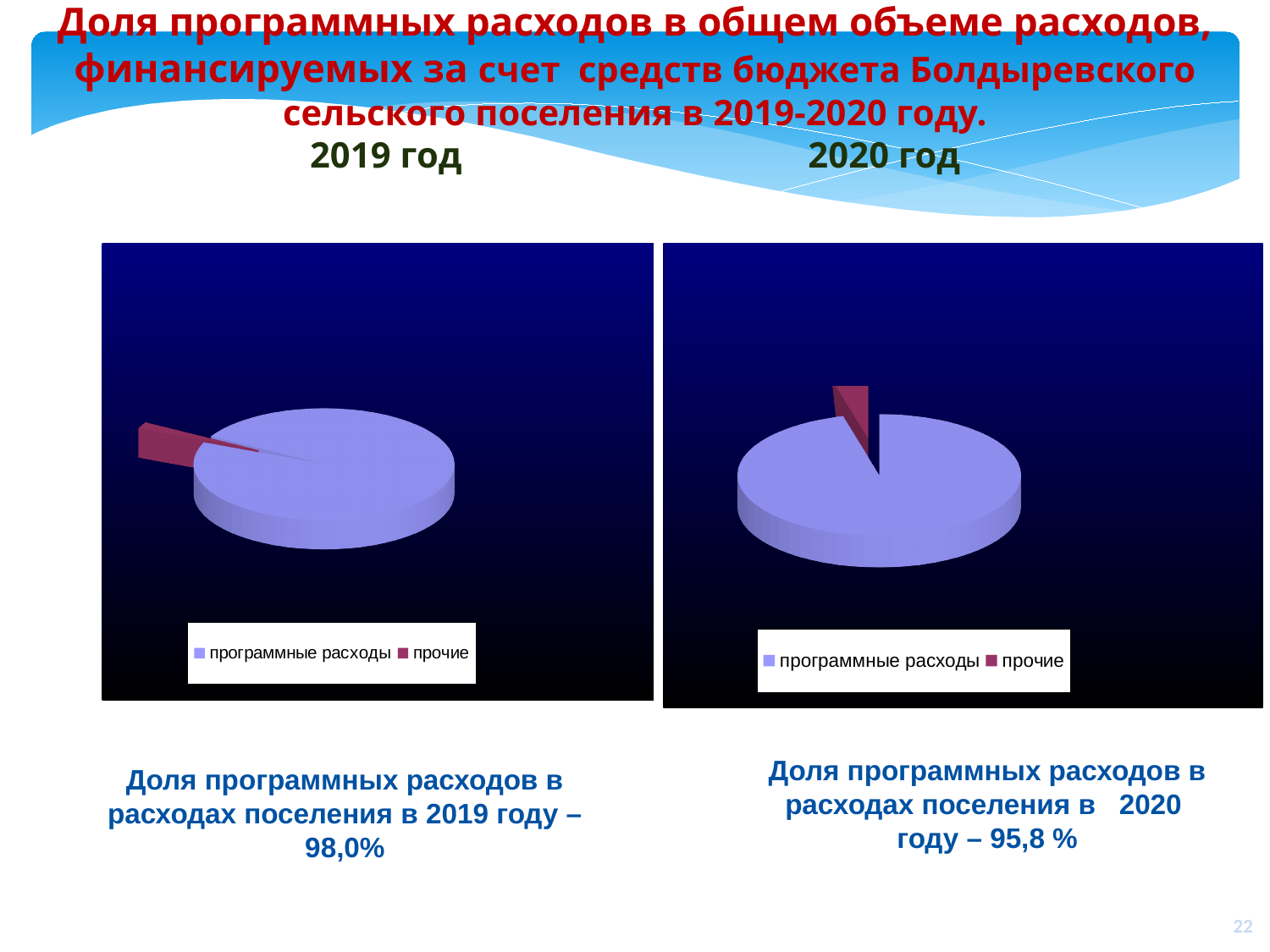
Which year has the larger share of программные расходы, 2019 год or 2020 год? 2019 год What kind of chart is shown for 2020 год? pie chart In the 2020 год chart, what share of the pie is программные расходы? 95,8 % In the 2019 год chart, what share of the pie is программные расходы? 98,0% In the 2020 год chart, which slice is the smallest? прочие What kind of chart is shown for 2019 год? pie chart In the 2020 год chart, what colour is the прочие slice? dark red In the 2020 год chart, how many entries does the legend list? 2 In the 2019 год chart, how many slices does the pie have? 2 In the 2019 год chart, is the share of программные расходы greater or less than 50%? greater In the 2019 год chart, what are the two legend entries? программные расходы, прочие In the 2019 год chart, which slice is the largest? программные расходы